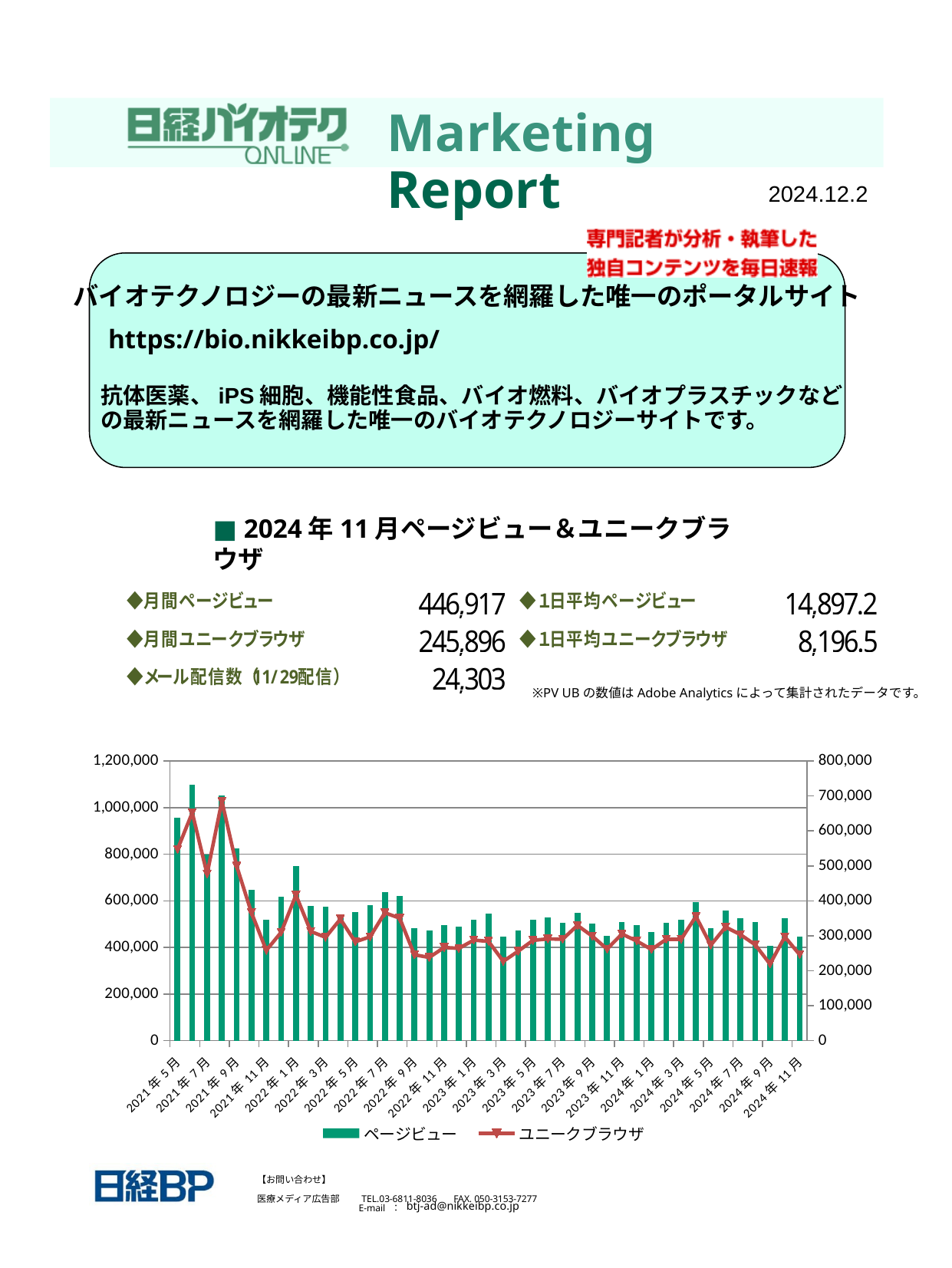
How many series does the chart legend list? 2 Which has the larger ページビュー value, 2022年1月 or 2022年3月? 2022年1月 Overall, do the ページビュー values rise or fall from 2021年5月 to 2024年11月? fall Is the ページビュー value for 2021年7月 greater or less than 1,000,000? less Which has the larger ページビュー value, 2021年7月 or 2024年11月? 2021年7月 Which series is drawn as a line in the chart? ユニークブラウザ Is the ページビュー value for 2024年11月 greater or less than 600,000? less Which series is drawn as bars in the chart? ページビュー In which month is the ページビュー bar highest? 2021年6月 Is the ユニークブラウザ value for 2024年11月 greater or less than 300,000? less What kind of chart is shown on the slide? A combination bar and line chart